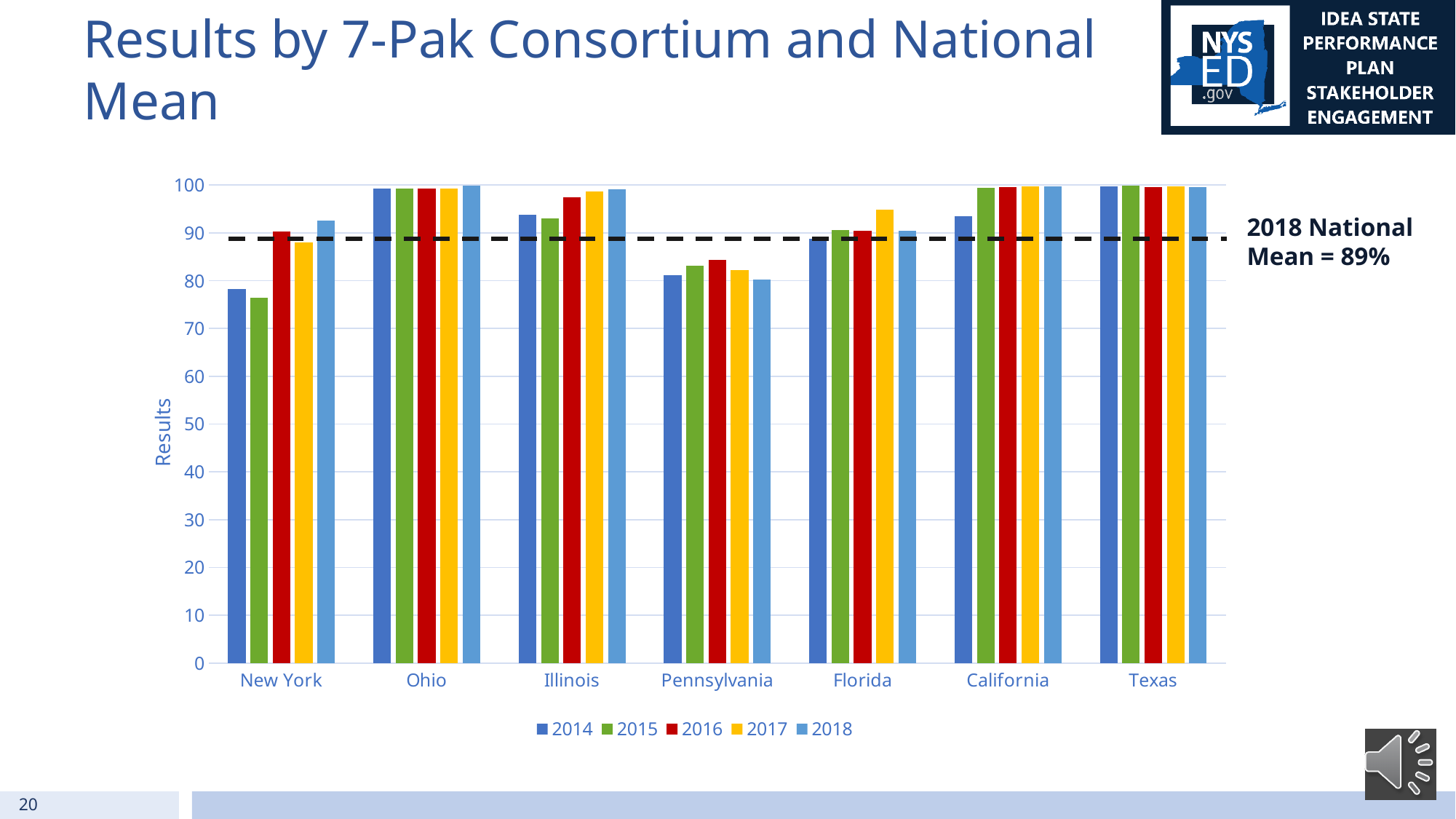
What is the 2018 National Mean shown by the dashed line on the chart? 89% Is the 2014 value for New York greater or less than 80? less What kind of chart is shown on the slide? bar chart Is the 2016 value for Pennsylvania greater or less than 80? greater Is the 2014 value for Ohio greater or less than 90? greater How many series does the chart's legend list? 5 How many states are shown on the x axis of the chart? 7 What is the label on the y axis of the chart? Results Which state has the lowest 2018 value? Pennsylvania Which is larger, the 2015 value for Illinois or the 2015 value for Pennsylvania? Illinois Which state has the lowest 2015 value? New York